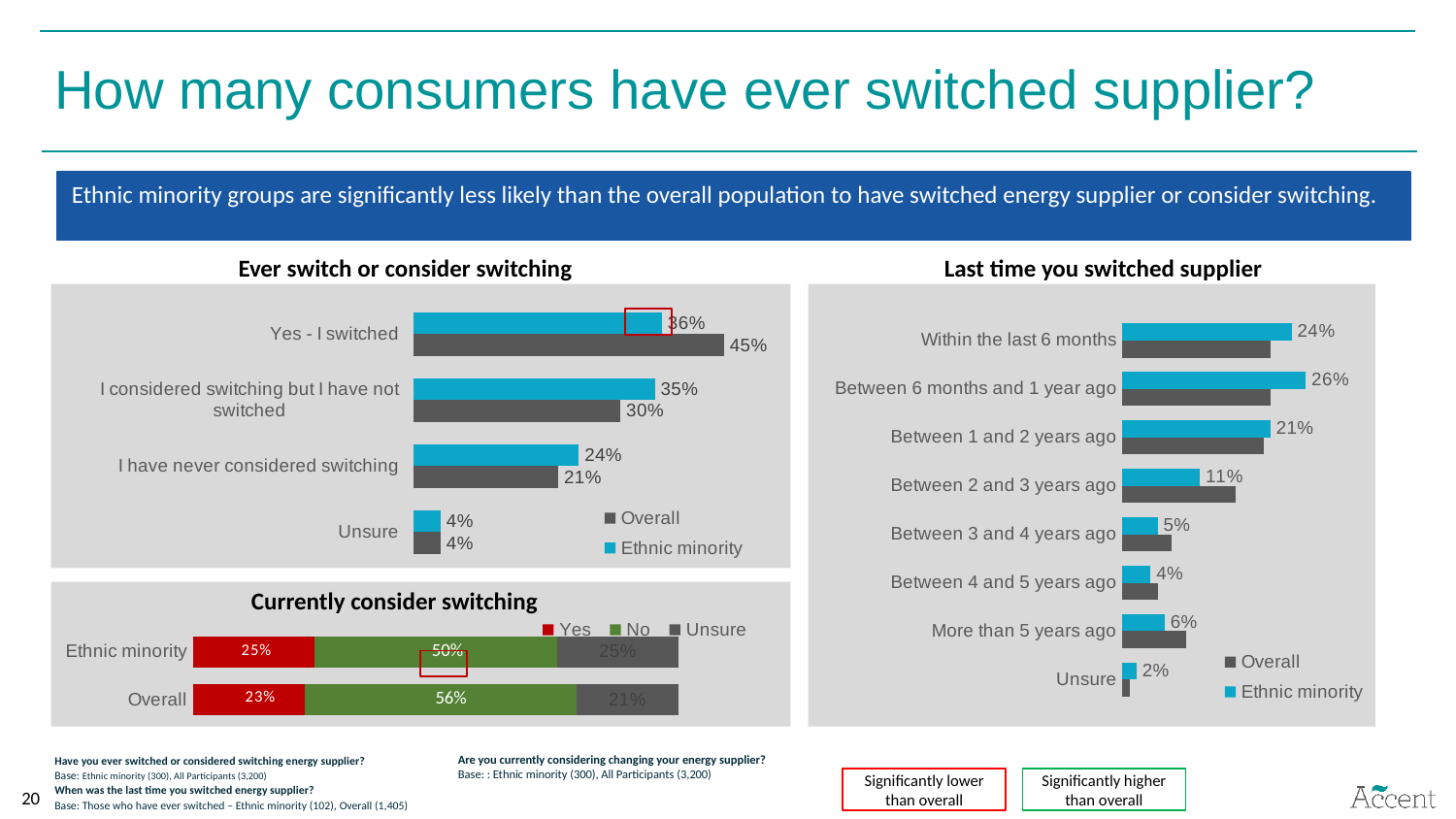
In the 'Last time you switched supplier' chart, what is the Ethnic minority value for 'Between 6 months and 1 year ago'? 26% In the 'Last time you switched supplier' chart, which category has the highest Ethnic minority value? Between 6 months and 1 year ago In the 'Ever switch or consider switching' chart, how many series does the legend list? 2 What type of chart is the 'Last time you switched supplier' chart? Bar chart In the 'Currently consider switching' chart, what is the 'Yes' value for Ethnic minority? 25% In the 'Ever switch or consider switching' chart, what is the Overall value for 'Yes - I switched'? 45% In the 'Ever switch or consider switching' chart, which category has the lowest Ethnic minority value? Unsure In the 'Last time you switched supplier' chart, how many categories are shown? 8 In the 'Currently consider switching' chart, what is the 'No' value for Overall? 56% In the 'Ever switch or consider switching' chart, what is the difference between the Overall and Ethnic minority values for 'Yes - I switched'? 9% In the 'Ever switch or consider switching' chart, what is the Ethnic minority value for 'I considered switching but I have not switched'? 35% In the 'Currently consider switching' chart, which is larger: the 'No' value for Ethnic minority or the 'No' value for Overall? Overall